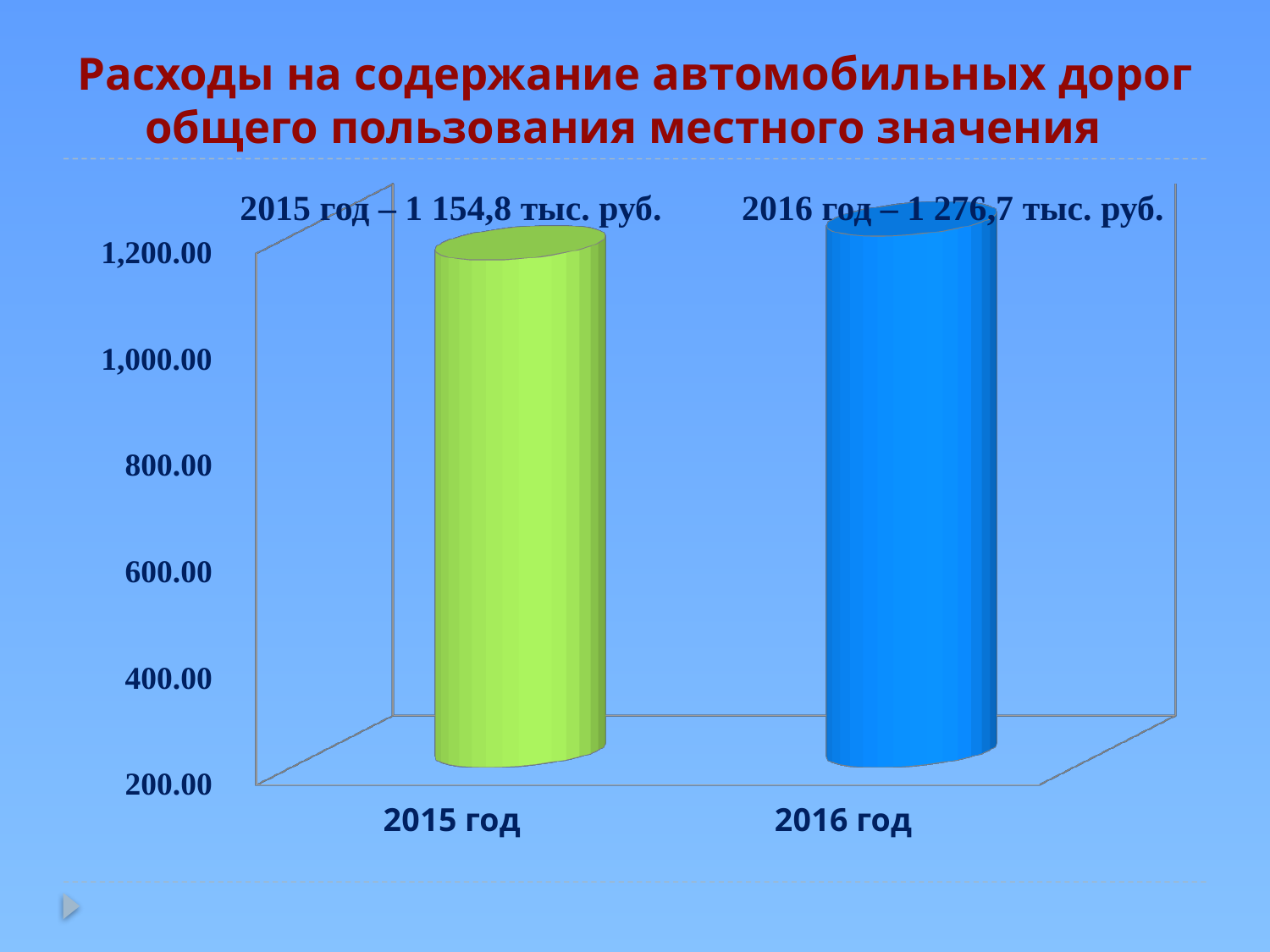
Do the values rise or fall from 2015 год to 2016 год? rise Which year has the highest value? 2016 год How many categories are shown on the chart? 2 What is the value for 2016 год? 1 276,7 тыс. руб. Which is larger, the value for 2015 год or the value for 2016 год? 2016 год What colour is the bar for 2016 год? blue What kind of chart is shown on the slide? bar chart What is the value for 2015 год? 1 154,8 тыс. руб. Which year has the lowest value? 2015 год What is the difference between the values for 2016 год and 2015 год? 121,9 тыс. руб. Is the value for 2015 год greater or less than 1,000.00? greater Is the value for 2016 год greater or less than 1,200.00? greater